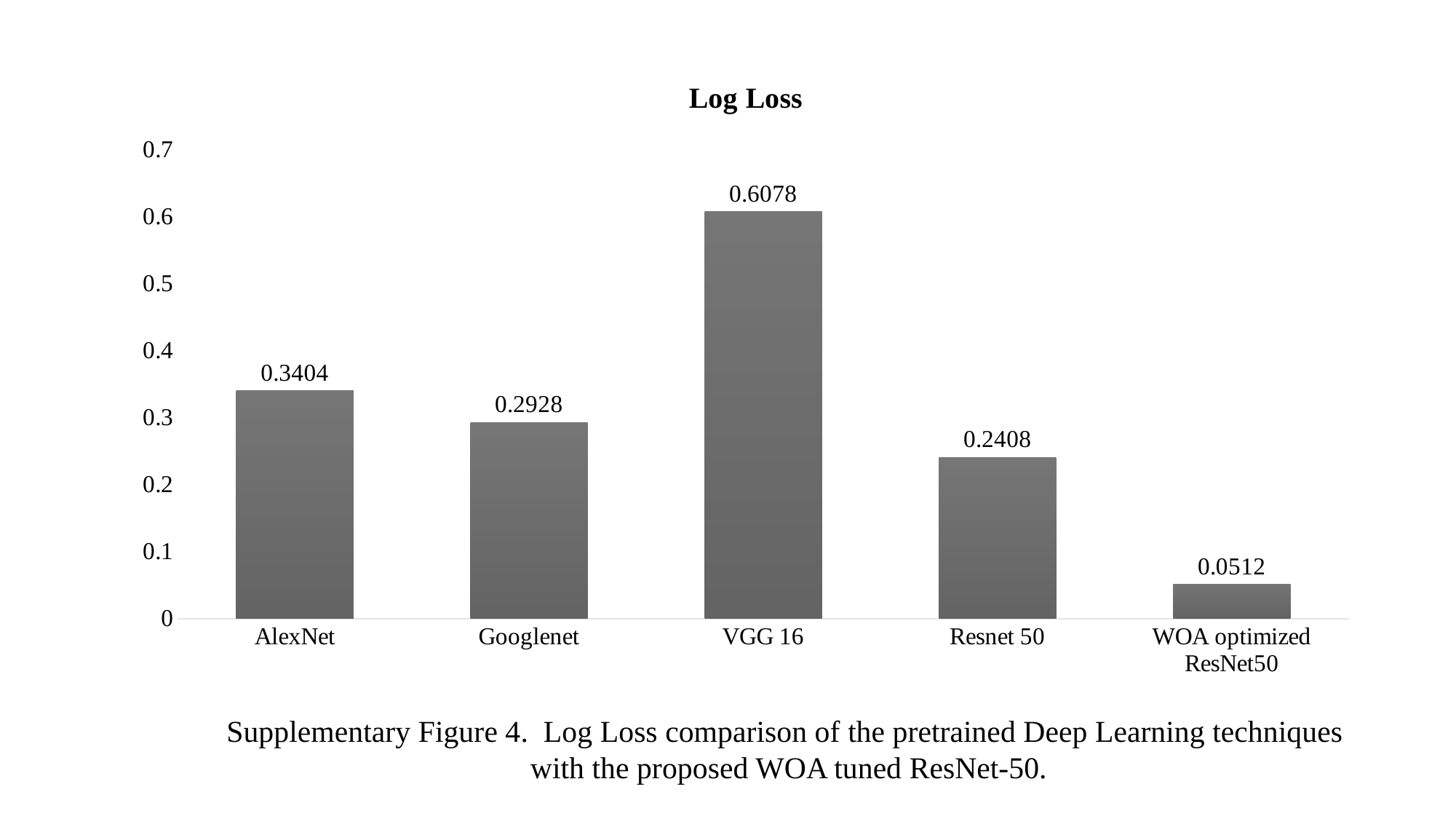
What is the Log Loss value for AlexNet? 0.3404 Which model has the highest Log Loss? VGG 16 What is the title of the chart? Log Loss What is the Log Loss value for VGG 16? 0.6078 Which model has the lowest Log Loss? WOA optimized ResNet50 Is the Log Loss value for VGG 16 greater or less than 0.5? greater How many models are shown on the chart? 5 What is the Log Loss value for WOA optimized ResNet50? 0.0512 What kind of chart is shown on the slide? Bar chart Which has a larger Log Loss, Googlenet or Resnet 50? Googlenet What is the difference in Log Loss between AlexNet and Googlenet? 0.0476 What is the difference in Log Loss between VGG 16 and Resnet 50? 0.3670